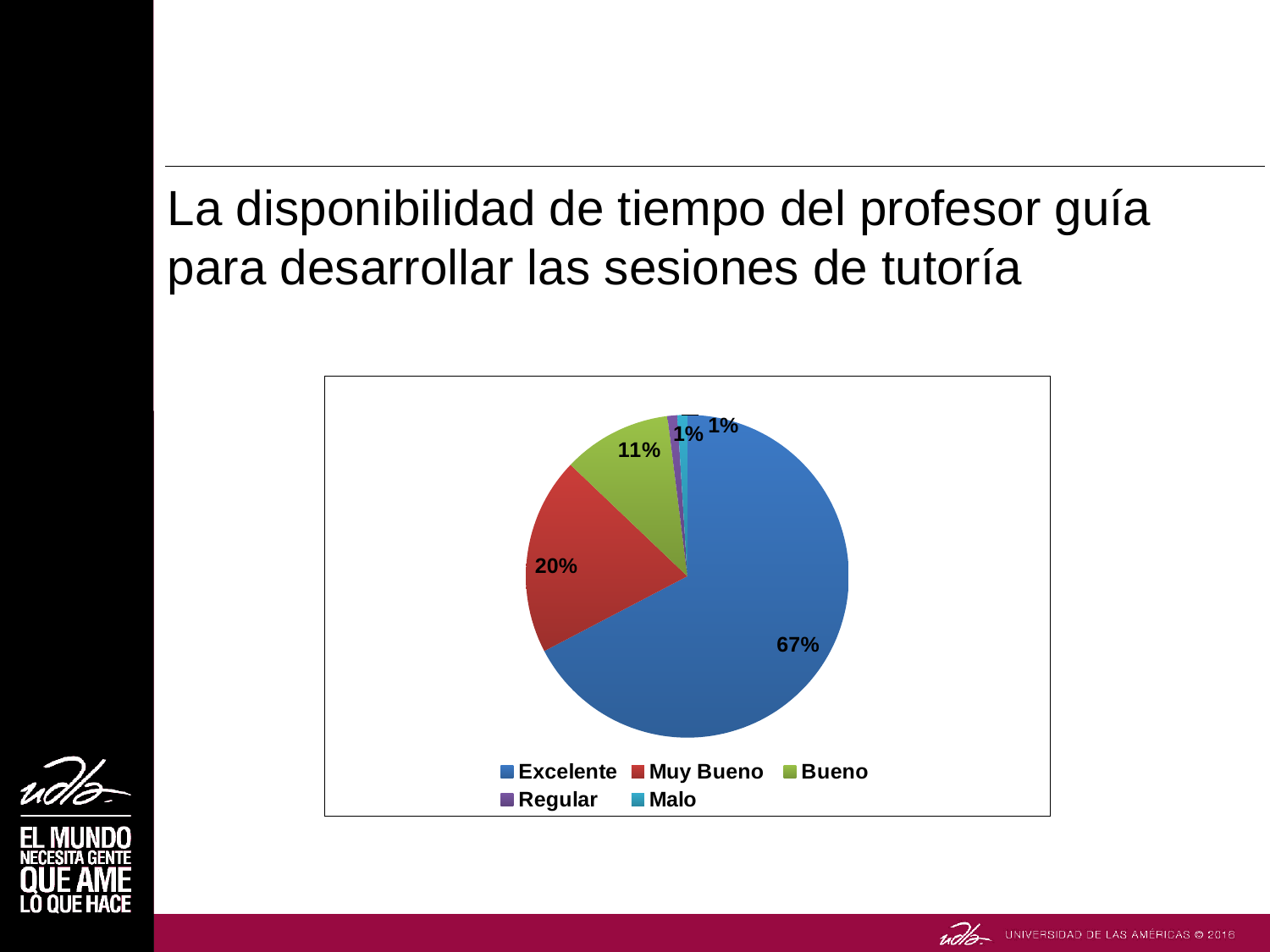
What percentage of the pie is labelled Regular? 1% What is the difference between the Excelente and Muy Bueno percentages? 47% How many slices does the pie chart have? 5 What is the combined share of the Muy Bueno and Bueno slices? 31% What percentage of the pie is labelled Muy Bueno? 20% What kind of chart is shown on the slide? pie chart Which category has the largest slice of the pie? Excelente Which slice is larger, Muy Bueno or Bueno? Muy Bueno What percentage of the pie is labelled Excelente? 67% How many entries does the legend list? 5 Which legend entry is shown in green? Bueno What percentage of the pie is labelled Bueno? 11%